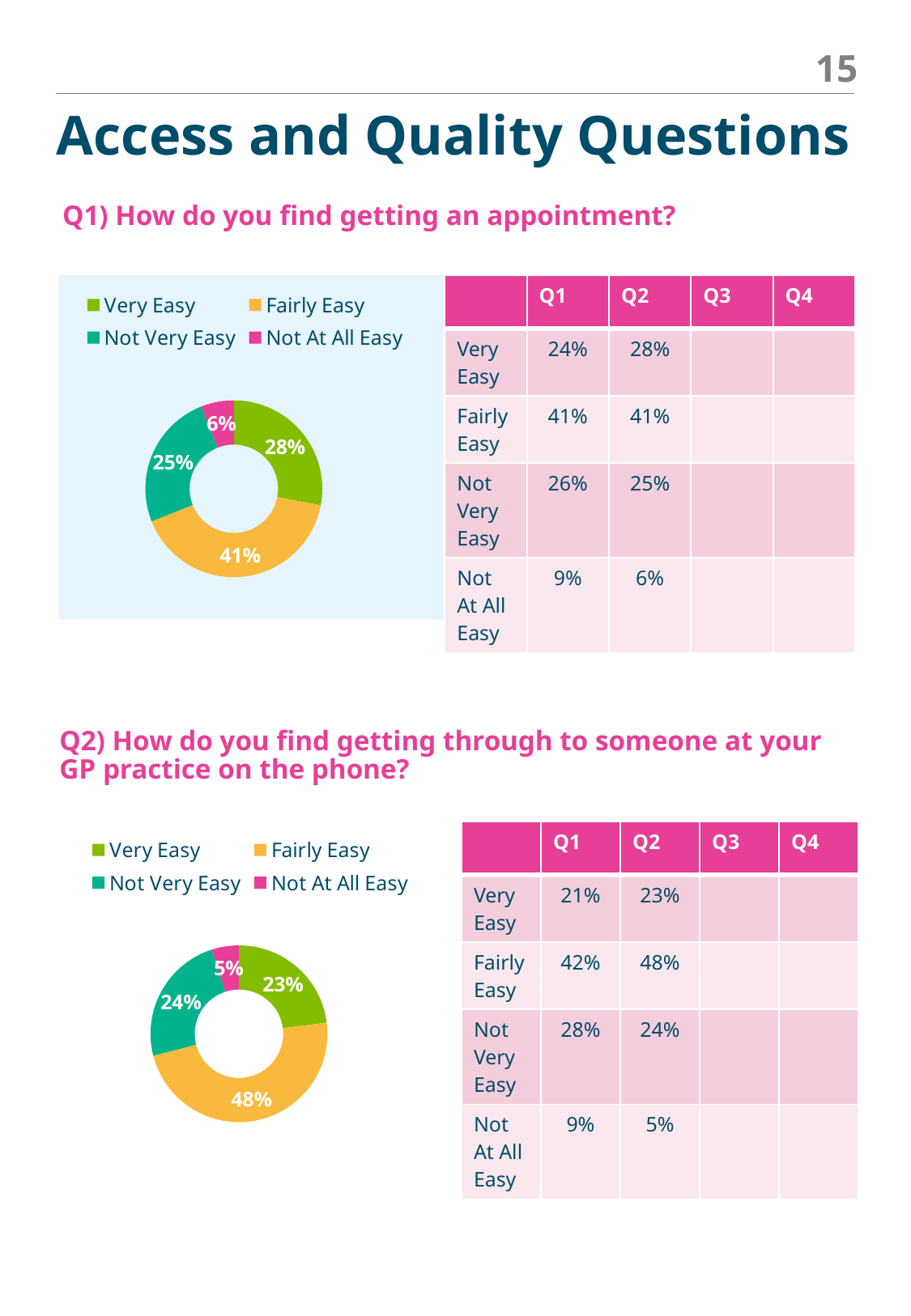
In the chart for Q1 (getting an appointment), what percentage is shown for Not At All Easy? 6% In the chart for Q1 (getting an appointment), what percentage is shown for Fairly Easy? 41% In the chart for Q2 (getting through on the phone), which is larger, Very Easy or Not Very Easy? Not Very Easy How many categories does the legend of the Q1 chart list? 4 In the chart for Q2 (getting through on the phone), what percentage is shown for Fairly Easy? 48% In the chart for Q2 (getting through on the phone), which category has the smallest share? Not At All Easy In the chart for Q2 (getting through on the phone), what is the difference between the Fairly Easy and Very Easy shares? 25% In the chart for Q1 (getting an appointment), what is the difference between the Very Easy and Not Very Easy shares? 3% What kind of chart is used for Q2 (getting through on the phone)? Doughnut chart In the chart for Q1 (getting an appointment), which category has the largest share? Fairly Easy In the chart for Q1 (getting an appointment), which category has the smallest share? Not At All Easy In the chart for Q2 (getting through on the phone), what percentage is shown for Not Very Easy? 24%